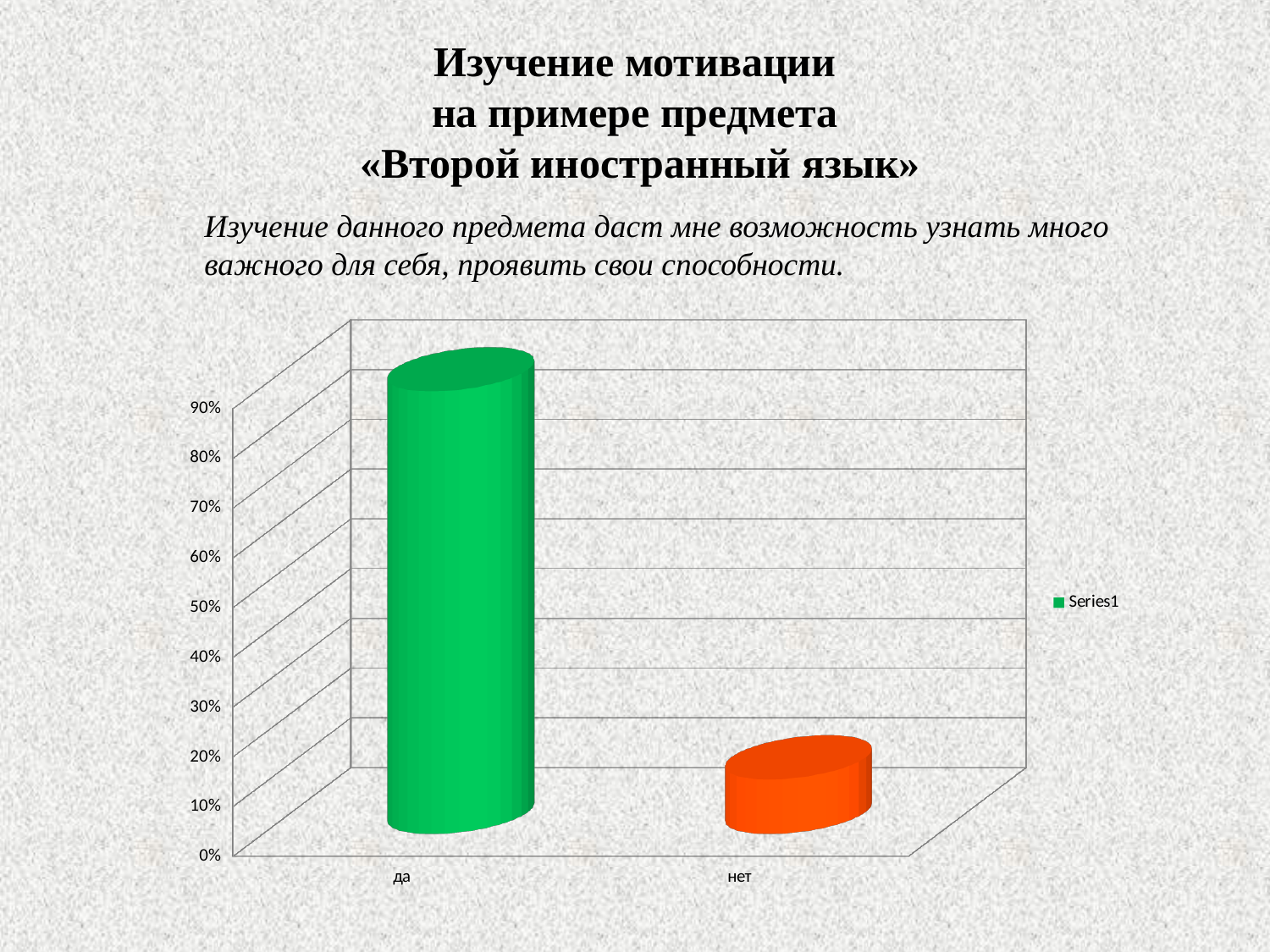
What is the name of the series shown in the chart legend? Series1 Is the value for нет greater or less than 30%? less Is the value for да greater or less than 50%? greater How many series does the chart legend list? 1 Is the value for нет greater or less than 50%? less How many categories are shown on the x axis of the chart? 2 Which category has the lowest value in the chart? нет What colour is the bar for the category да? green Which is larger, the value for да or the value for нет? да What kind of chart is shown on the slide? bar chart Which category has the highest value in the chart? да